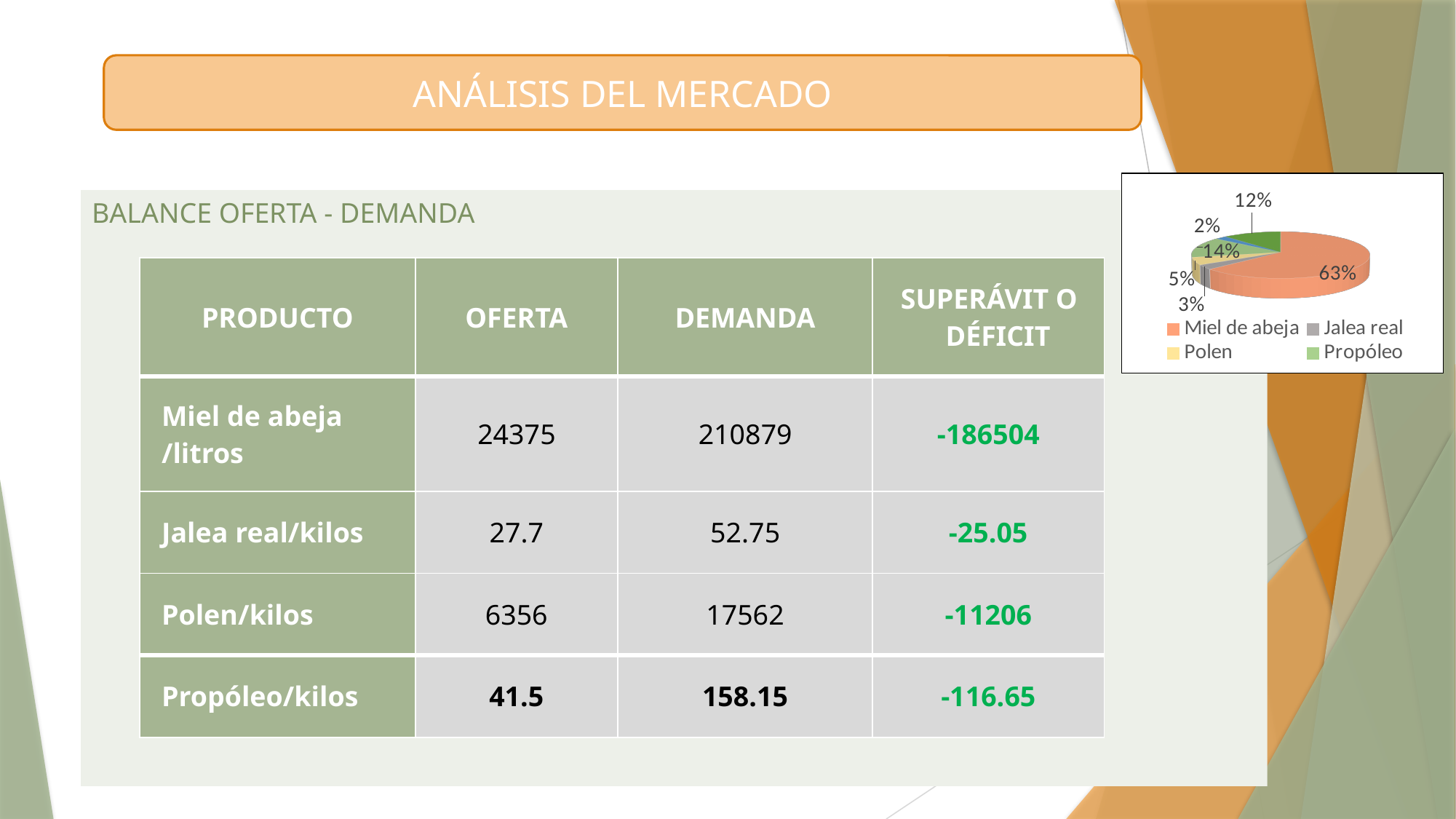
How many entries does the pie chart's legend list? 4 Which legend entry corresponds to the largest slice of the pie chart? Miel de abeja Which is larger on the pie chart, the 14% slice or the 12% slice? the 14% slice What is the difference between the 63% slice and the 12% slice on the pie chart? 51% What is the smallest percentage labelled on the pie chart? 2% What is the largest percentage shown on the pie chart? 63% What colour is the Miel de abeja slice in the pie chart? orange What kind of chart is shown on the slide? pie chart Which legend entry is shown in green in the pie chart? Propóleo Is the share for Miel de abeja greater or less than 50%? greater How many percentage labels are shown on the pie chart? 6